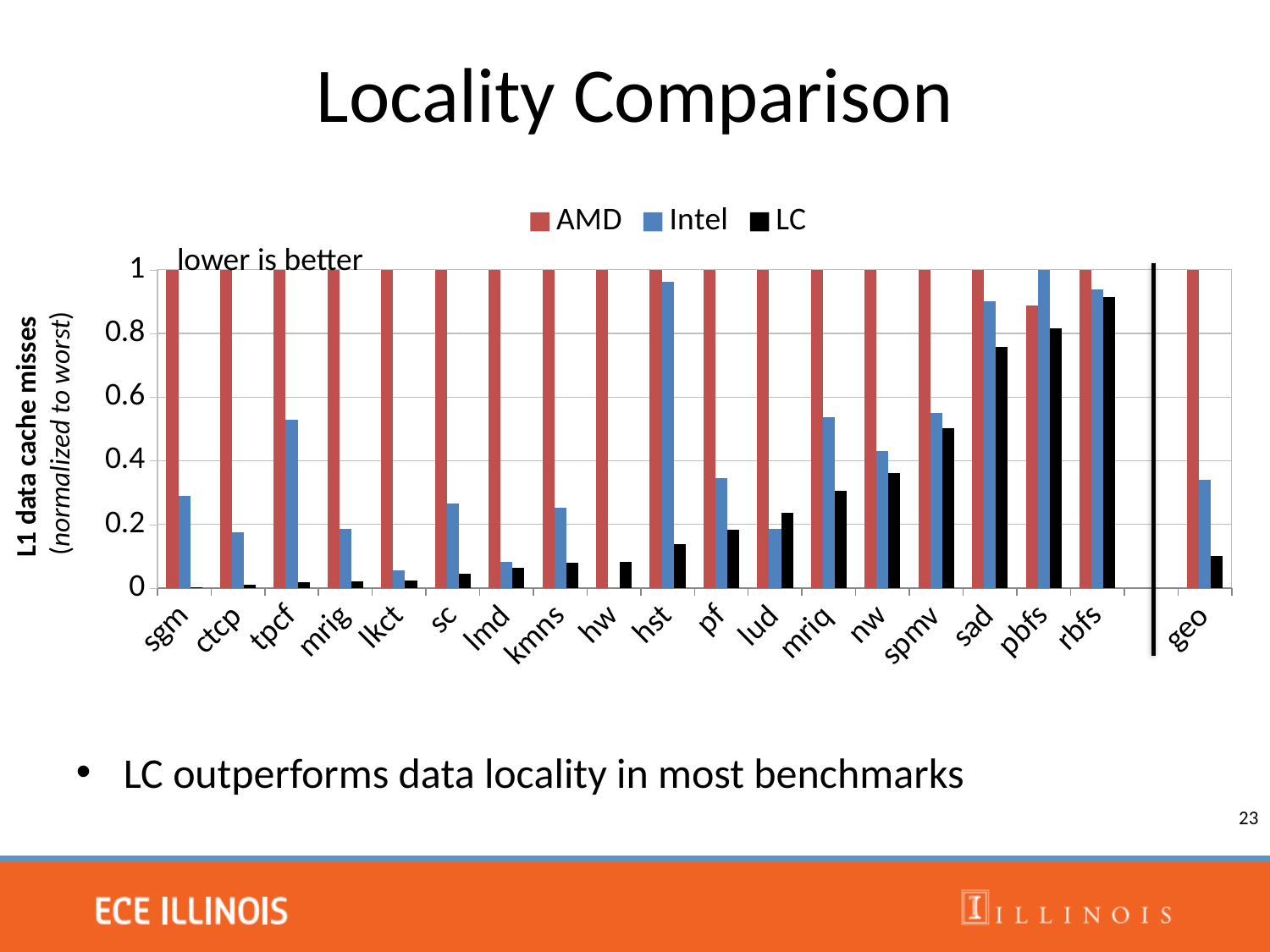
Is the LC value for geo greater or less than 0.2? less What kind of chart is shown on the slide? bar chart Is the LC value for sad greater or less than 0.6? greater Is the Intel value for tpcf greater or less than 0.4? greater What is the Intel value for pbfs? 1 Which category has the highest LC value? rbfs How many series does the legend list? 3 For lud, which is larger: the Intel value or the LC value? LC What is the AMD value for sgm? 1 For pbfs, which is larger: the AMD value or the Intel value? Intel How many categories are shown along the x axis? 19